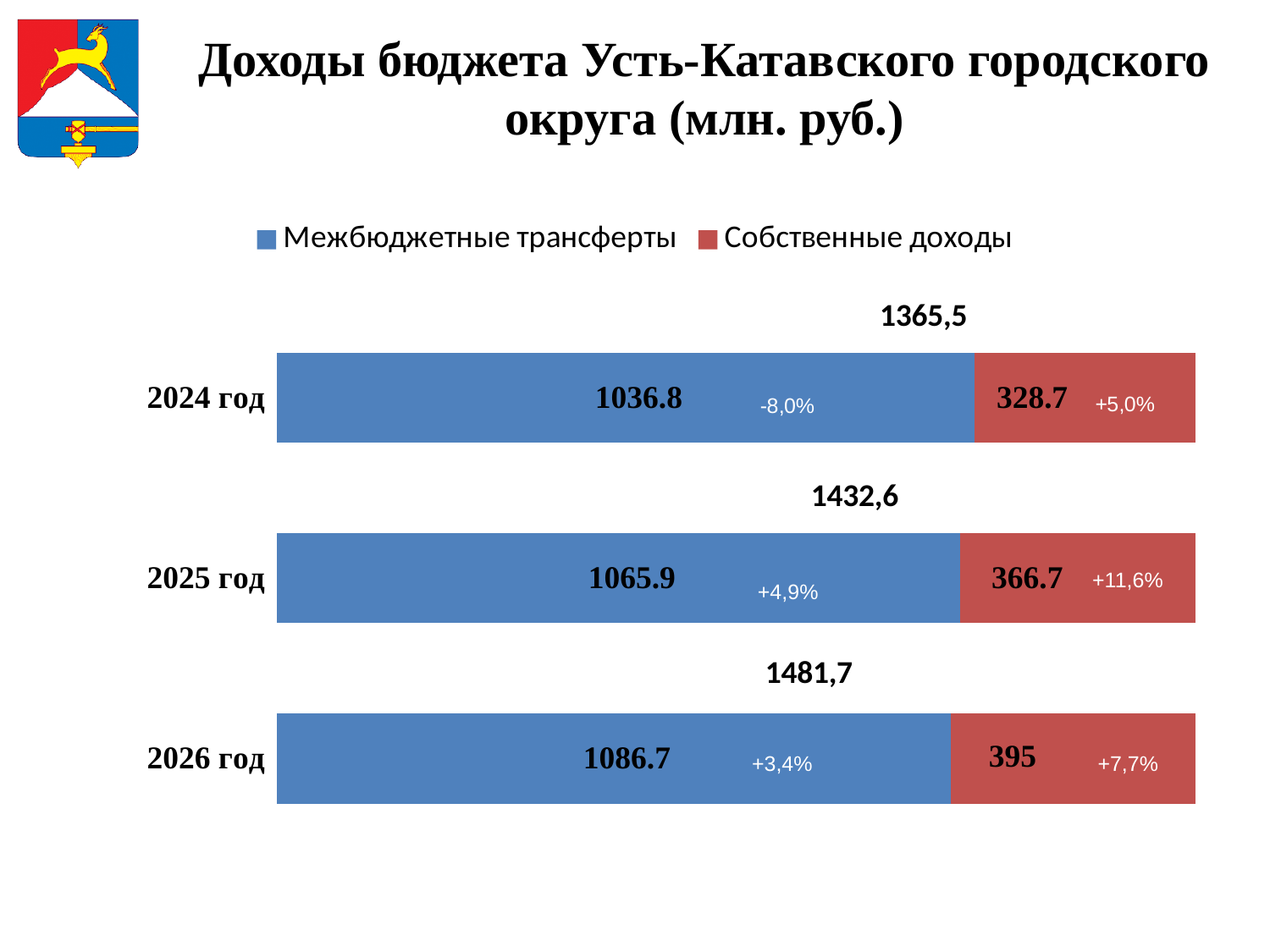
How many series does the legend list? 2 What is the difference between Собственные доходы in 2026 год and 2024 год? 66.3 What is the value of Собственные доходы for 2025 год? 366.7 How many years are shown in the chart? 3 What is the value of Межбюджетные трансферты for 2024 год? 1036.8 What is the total shown above the bar for 2026 год? 1481,7 What is the value of Собственные доходы for 2026 год? 395 Which is larger: Межбюджетные трансферты in 2025 год or in 2024 год? 2025 год What kind of chart is shown on the slide? Stacked bar chart Which year has the lowest value for Собственные доходы? 2024 год What is the total shown above the bar for 2025 год? 1432,6 Which year has the highest value for Межбюджетные трансферты? 2026 год